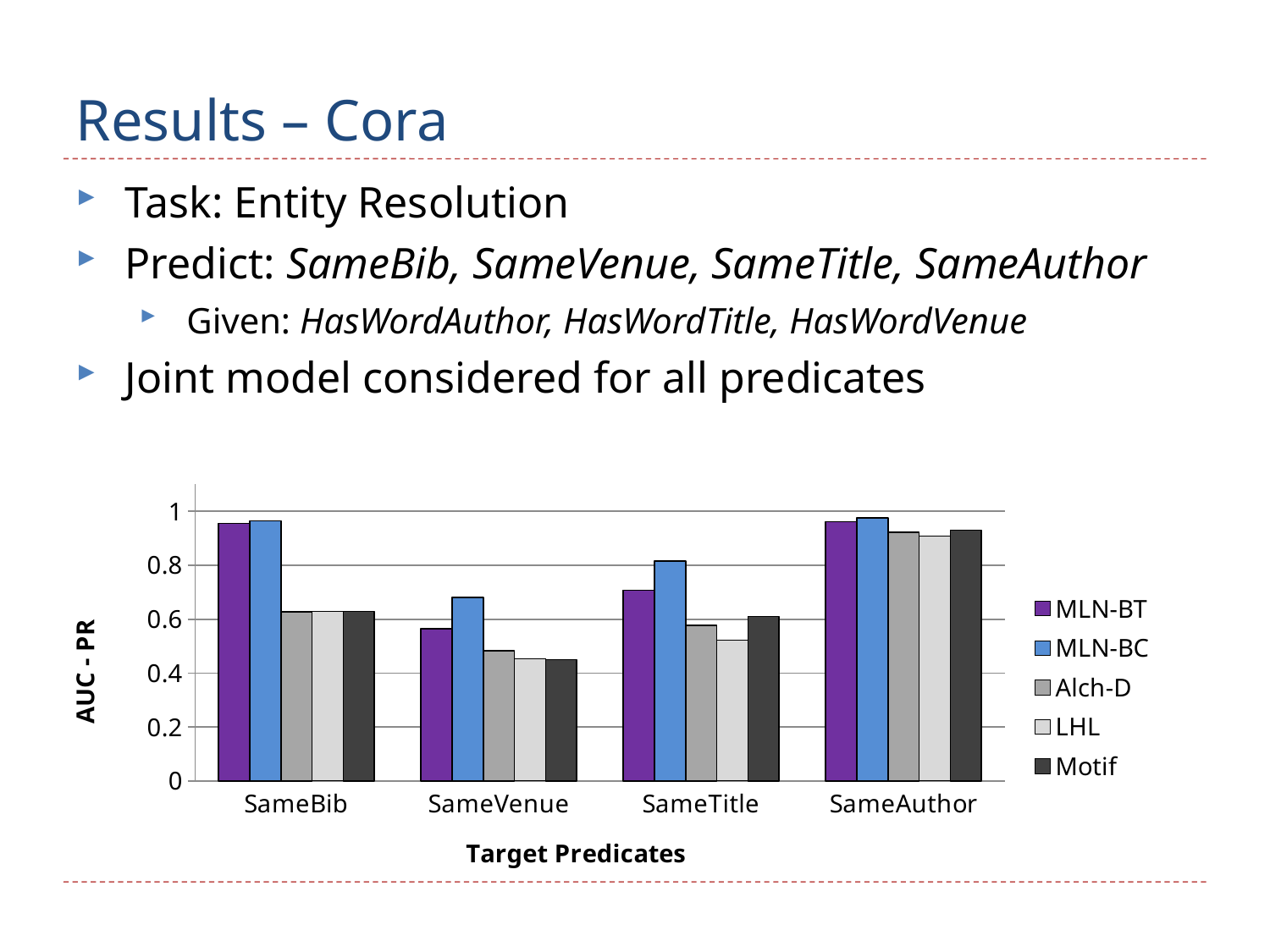
For SameTitle, which is larger: the MLN-BC value or the Alch-D value? MLN-BC How many series does the chart's legend list? 5 What is the label on the chart's y axis? AUC - PR Is the MLN-BC value for SameVenue greater or less than 0.6? greater Is the MLN-BT value for SameAuthor greater or less than 0.8? greater What kind of chart is shown on the slide? bar chart Which series has the lowest AUC-PR for SameTitle? LHL Is the Motif value for SameBib greater or less than 0.8? less Which series has the highest AUC-PR for SameTitle? MLN-BC How many target predicates are shown on the x axis of the chart? 4 For SameVenue, which is larger: the MLN-BT value or the LHL value? MLN-BT